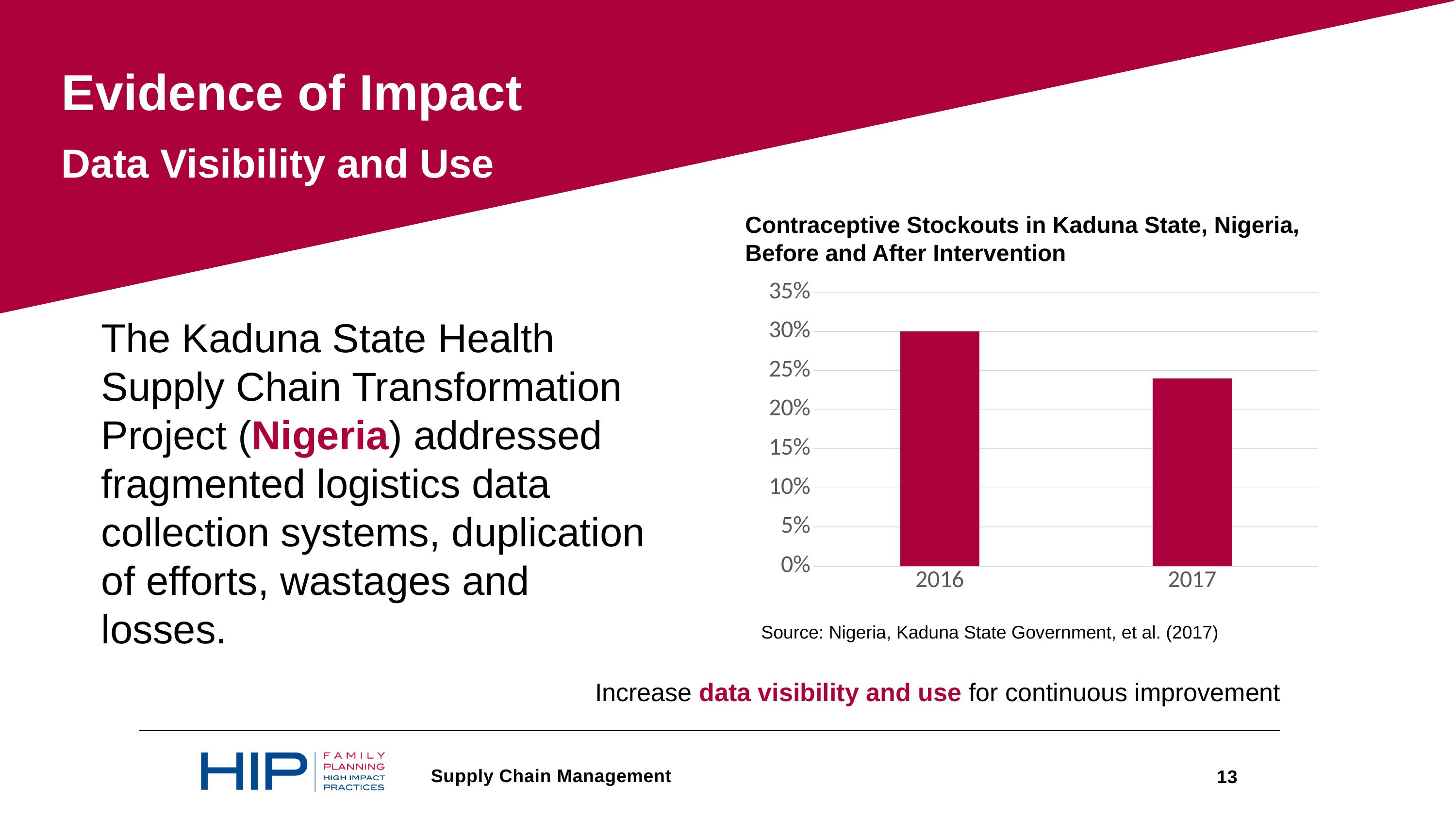
Is the value for 2017 greater or less than 25%? less What is the contraceptive stockout rate for 2016? 30% Which is larger, the stockout rate in 2016 or in 2017? 2016 Is the value for 2017 greater or less than 20%? greater Which year has the lowest contraceptive stockout rate? 2017 Which year has the highest contraceptive stockout rate? 2016 How many years are plotted in the chart? 2 What kind of chart is shown on the slide? bar chart What is the highest value shown on the chart's vertical axis? 35% Is the value for 2016 greater or less than 25%? greater Do the stockout values rise or fall from 2016 to 2017? fall What is the title of the chart? Contraceptive Stockouts in Kaduna State, Nigeria, Before and After Intervention